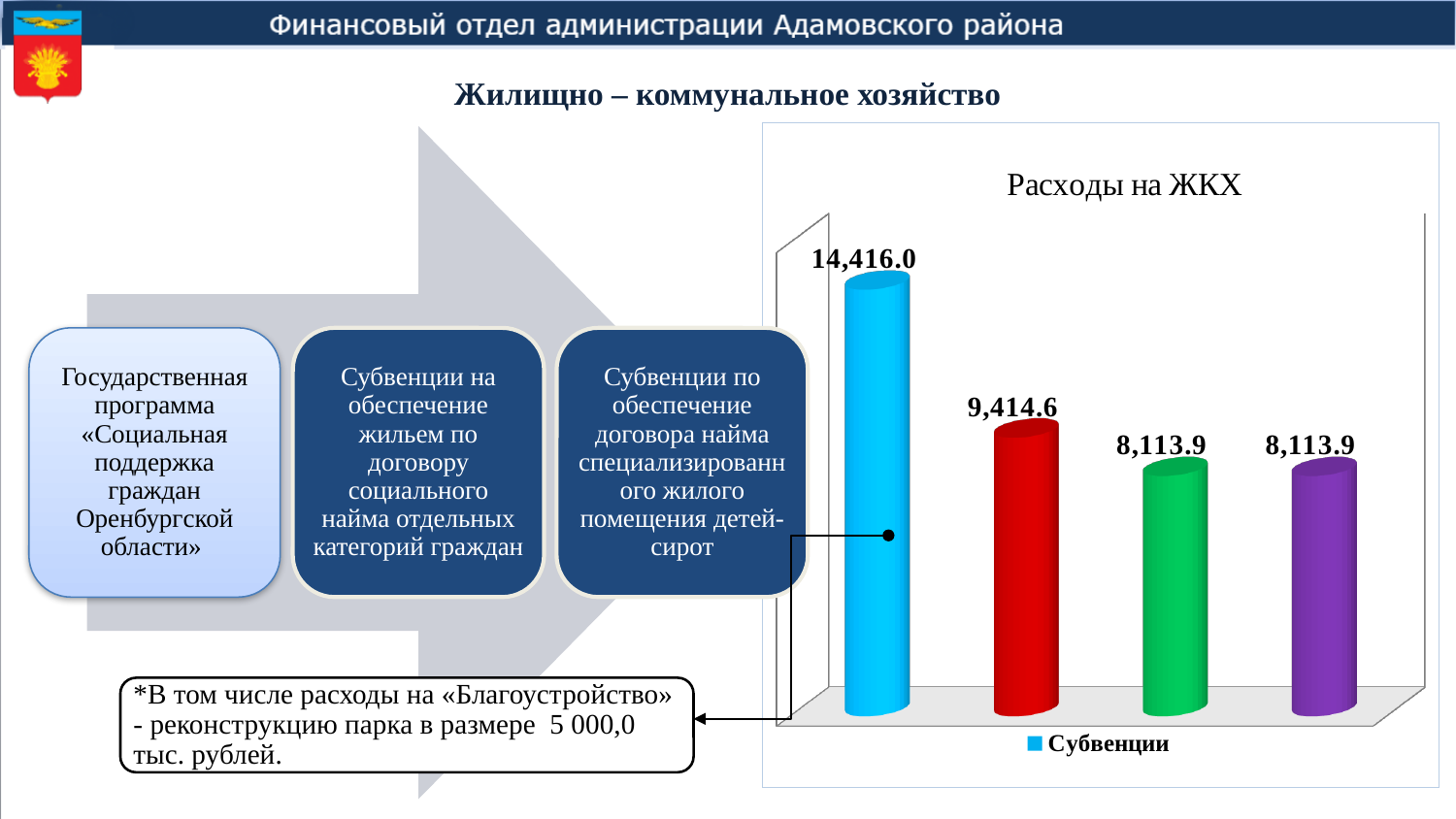
How many series does the chart legend list? 1 What is the value shown on the fourth (purple) bar of the chart? 8,113.9 What is the value shown on the second (red) bar of the chart? 9,414.6 What is the value shown on the first (blue) bar of the chart? 14,416.0 What is the legend entry shown below the chart? Субвенции Do the bar values rise or fall from left to right across the chart? fall What is the lowest value shown in the chart? 8,113.9 How many bars are plotted in the chart? 4 What kind of chart is shown on the slide? bar chart What is the highest value shown in the chart? 14,416.0 What is the title of the chart on the slide? Расходы на ЖКХ What is the difference between the first (blue) bar and the second (red) bar? 5,001.4